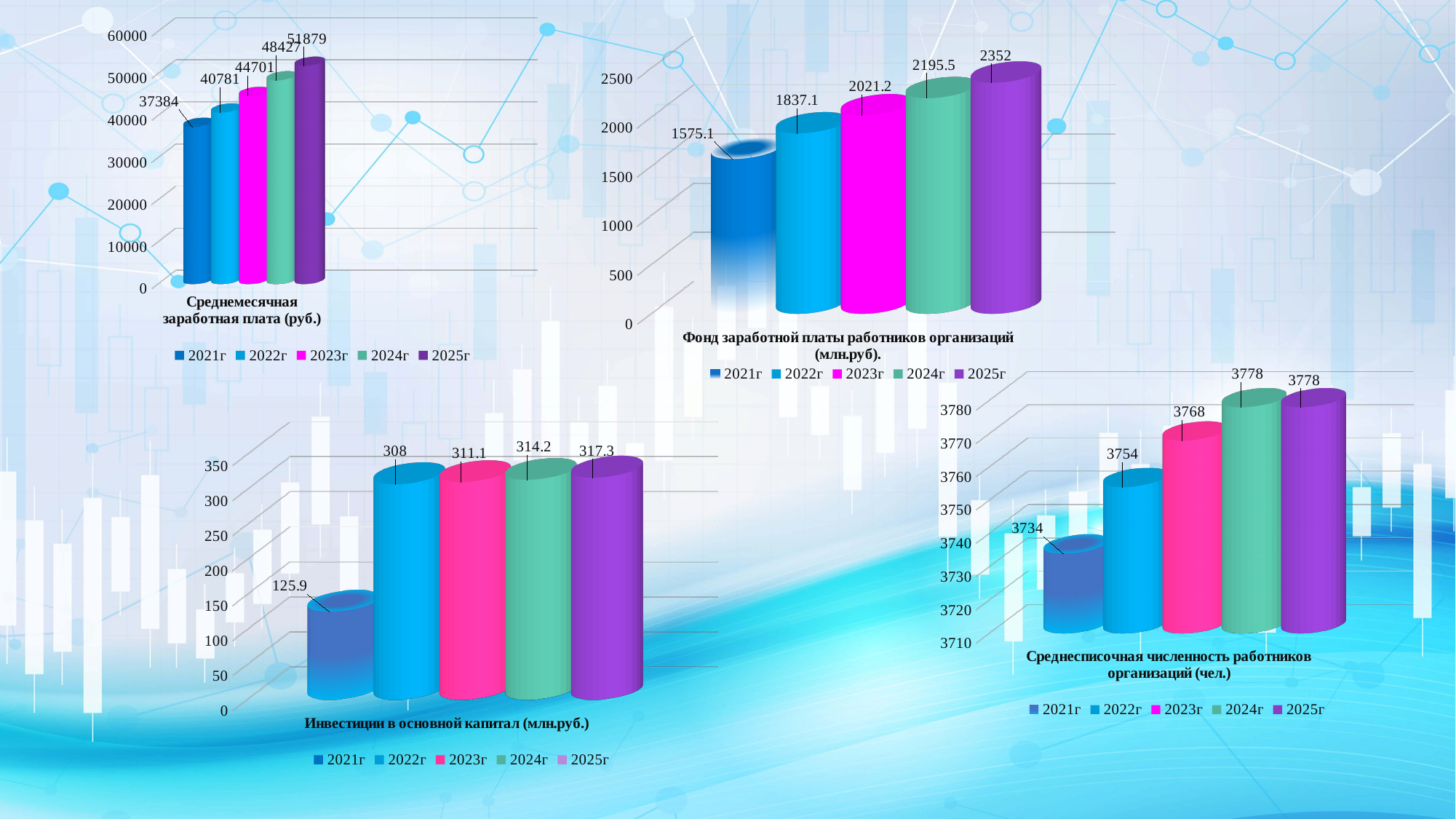
In the chart titled 'Среднемесячная заработная плата (руб.)', what is the difference between the 2025г and 2021г values? 14495 In the chart titled 'Фонд заработной платы работников организаций (млн.руб).', which year has the lowest value? 2021г In the chart titled 'Среднесписочная численность работников организаций (чел.)', what is the value for 2023г? 3768 In the chart titled 'Инвестиции в основной капитал (млн.руб.)', how many series does the legend list? 5 In the chart titled 'Фонд заработной платы работников организаций (млн.руб).', do the values rise or fall from 2021г to 2025г? rise In the chart titled 'Среднесписочная численность работников организаций (чел.)', which is larger, the value for 2022г or the value for 2021г? 2022г In the chart titled 'Среднемесячная заработная плата (руб.)', what is the value for 2023г? 44701 In the chart titled 'Инвестиции в основной капитал (млн.руб.)', what is the difference between the 2022г and 2021г values? 182.1 In the chart titled 'Фонд заработной платы работников организаций (млн.руб).', what is the value for 2022г? 1837.1 In the chart titled 'Инвестиции в основной капитал (млн.руб.)', what is the value for 2021г? 125.9 What kind of chart is the one titled 'Среднесписочная численность работников организаций (чел.)'? bar chart In the chart titled 'Среднемесячная заработная плата (руб.)', which year has the highest value? 2025г